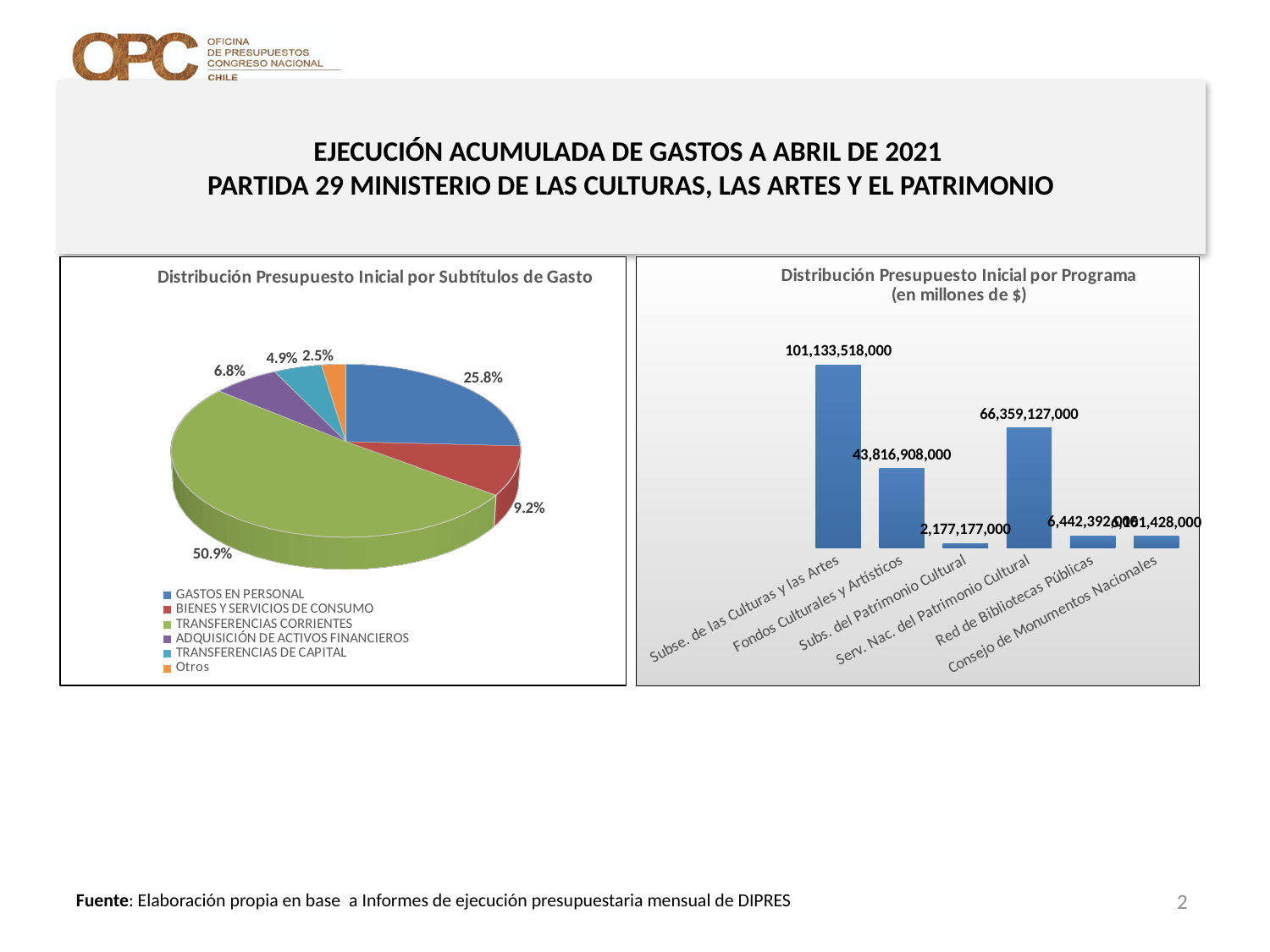
In the chart 'Distribución Presupuesto Inicial por Subtítulos de Gasto', what share does TRANSFERENCIAS CORRIENTES have? 50.9% In the chart 'Distribución Presupuesto Inicial por Subtítulos de Gasto', what percentage is shown for GASTOS EN PERSONAL? 25.8% In the chart 'Distribución Presupuesto Inicial por Programa', which program has the lowest value? Subs. del Patrimonio Cultural What kind of chart is 'Distribución Presupuesto Inicial por Subtítulos de Gasto'? Pie chart In the chart 'Distribución Presupuesto Inicial por Subtítulos de Gasto', which category has the smallest slice? Otros What kind of chart is 'Distribución Presupuesto Inicial por Programa'? Bar chart In the chart 'Distribución Presupuesto Inicial por Subtítulos de Gasto', how many categories does the legend list? 6 In the chart 'Distribución Presupuesto Inicial por Programa', what is the difference between Subse. de las Culturas y las Artes and Serv. Nac. del Patrimonio Cultural? 34,774,391,000 In the chart 'Distribución Presupuesto Inicial por Subtítulos de Gasto', how many percentage points larger is GASTOS EN PERSONAL than BIENES Y SERVICIOS DE CONSUMO? 16.6 percentage points In the chart 'Distribución Presupuesto Inicial por Subtítulos de Gasto', which category has the largest slice? TRANSFERENCIAS CORRIENTES In the chart 'Distribución Presupuesto Inicial por Programa', which is larger: Fondos Culturales y Artísticos or Serv. Nac. del Patrimonio Cultural? Serv. Nac. del Patrimonio Cultural In the chart 'Distribución Presupuesto Inicial por Programa', what is the value for Subse. de las Culturas y las Artes? 101,133,518,000